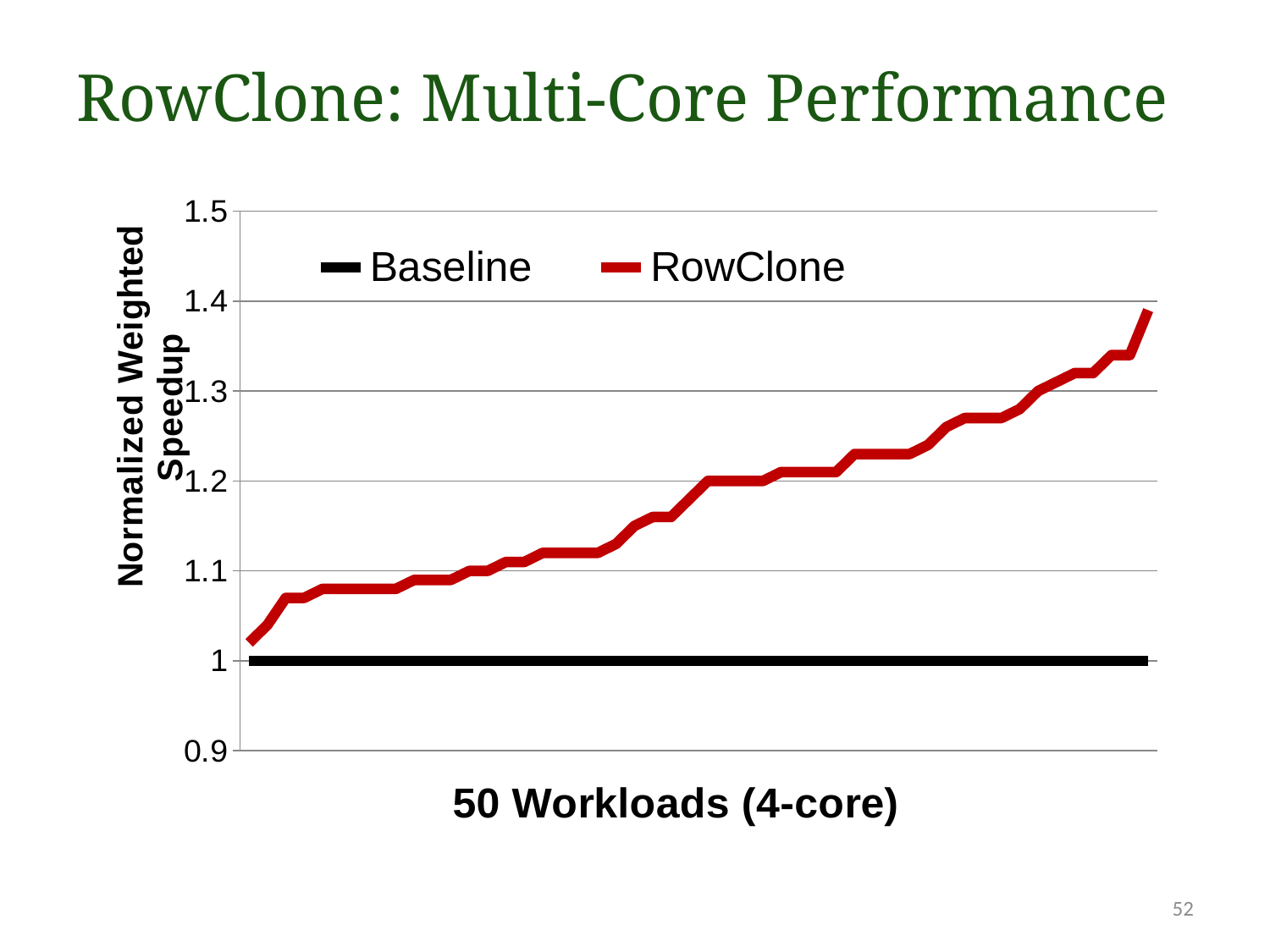
What is the normalized weighted speedup of the Baseline series across the workloads? 1 What is the label of the y axis? Normalized Weighted Speedup How many workloads are plotted along the x axis, according to the axis label? 50 Which series has the higher normalized weighted speedup, Baseline or RowClone? RowClone What kind of chart is shown on the slide? line chart Is the lowest value of the RowClone series greater or less than 1.1? less Does the RowClone series rise or fall from left to right along the x axis? rise How many series does the legend list? 2 What are the two series named in the legend? Baseline and RowClone Is the highest value of the RowClone series greater or less than 1.3? greater Which series is drawn in red? RowClone